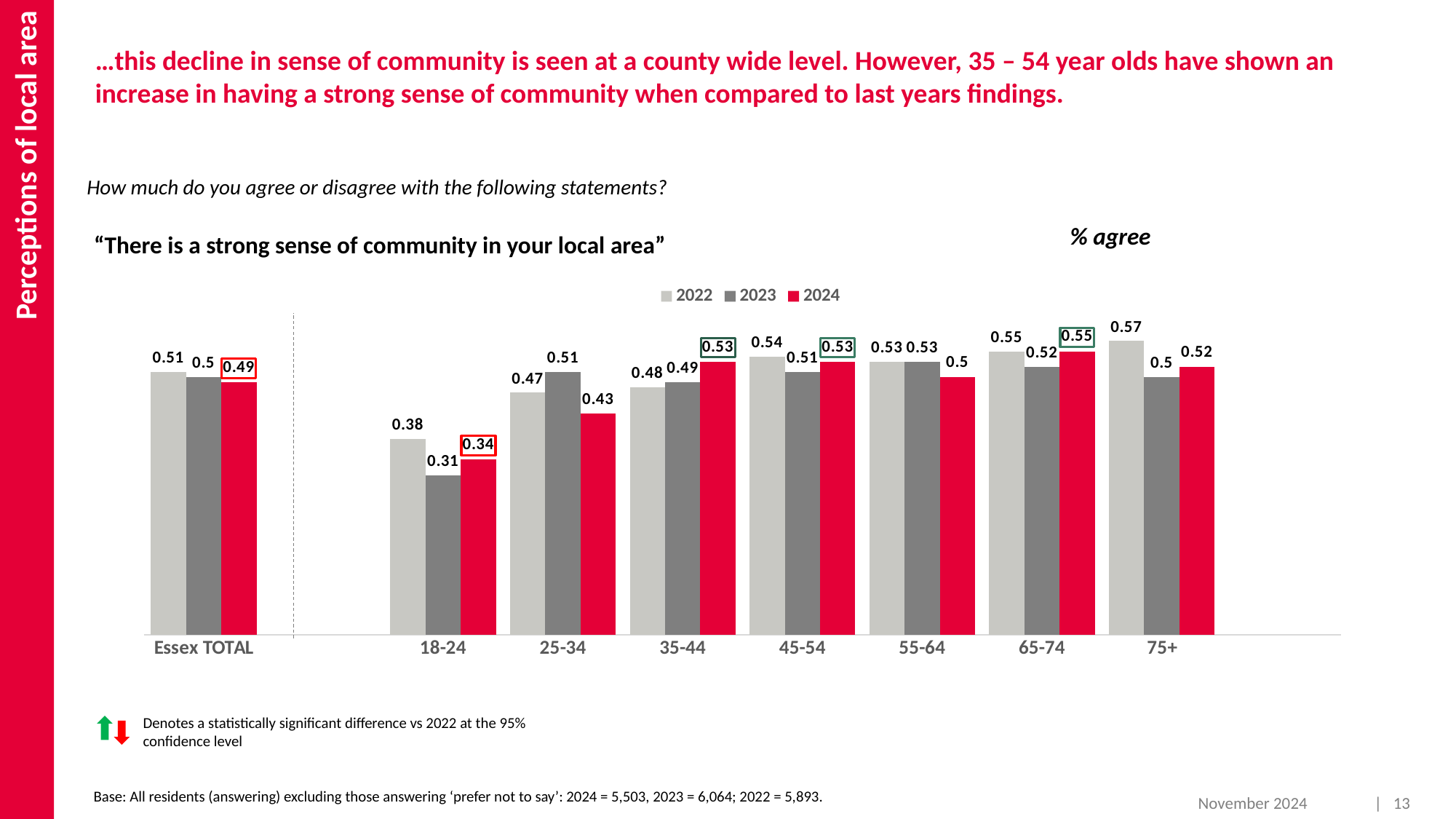
How many series does the legend list? 3 Which age group has the highest 2022 value? 75+ Which is larger for the 35-44 age group, the 2022 value or the 2024 value? 2024 What is the difference between the 2022 and 2024 values for the 75+ age group? 0.05 What is the 2022 value for Essex TOTAL? 0.51 What kind of chart is shown on the slide? Bar chart Which category has the lowest 2023 value? 18-24 Which series is shown in red in the legend? 2024 How many categories are shown on the x axis? 8 What is the 2023 value for the 25-34 age group? 0.51 What is the 2024 value for the 18-24 age group? 0.34 What is the difference between the 2023 and 2024 values for the 55-64 age group? 0.03